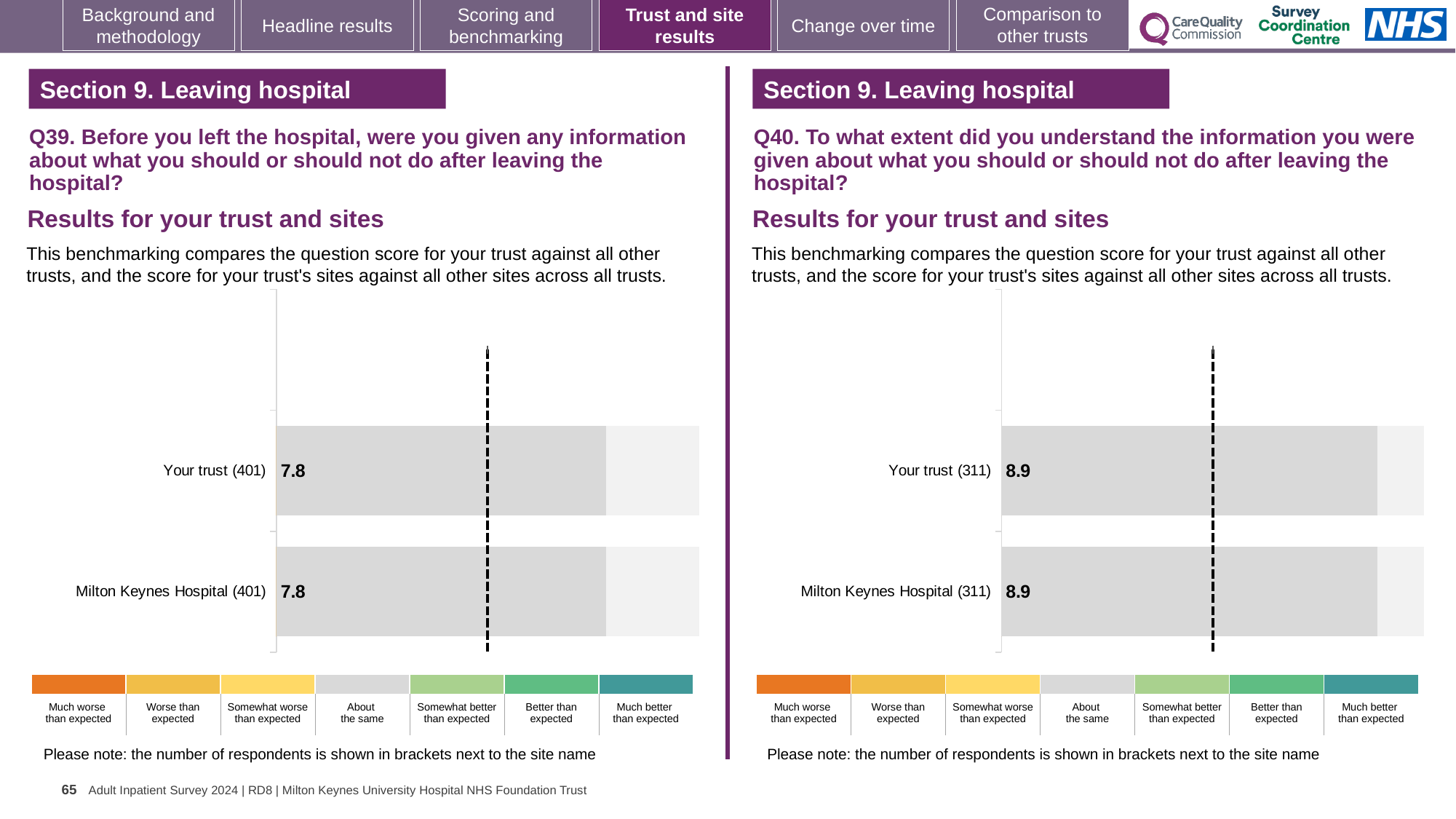
In the Q39 chart on the left, what is the score for Your trust? 7.8 In the Q40 chart on the right, how many respondents are shown in brackets next to Milton Keynes Hospital? 311 In the Q40 chart on the right, how many bars are plotted? 2 In the Q39 chart on the left, what is the score for Milton Keynes Hospital? 7.8 What kind of chart is the Q39 chart on the left? Bar chart Is the score for Your trust in the Q40 chart on the right larger or smaller than the score for Your trust in the Q39 chart on the left? Larger In the Q40 chart on the right, what is the score for Milton Keynes Hospital? 8.9 In the Q40 chart on the right, what is the score for Your trust? 8.9 In the Q39 chart on the left, what is the difference between the score for Your trust and the score for Milton Keynes Hospital? 0 In the Q39 chart on the left, how many respondents are shown in brackets next to Your trust? 401 In the Q39 chart on the left, how many categories does the colour key below the chart list? 7 In the Q40 chart on the right, which colour-key category does the grey colour of the bars correspond to? About the same